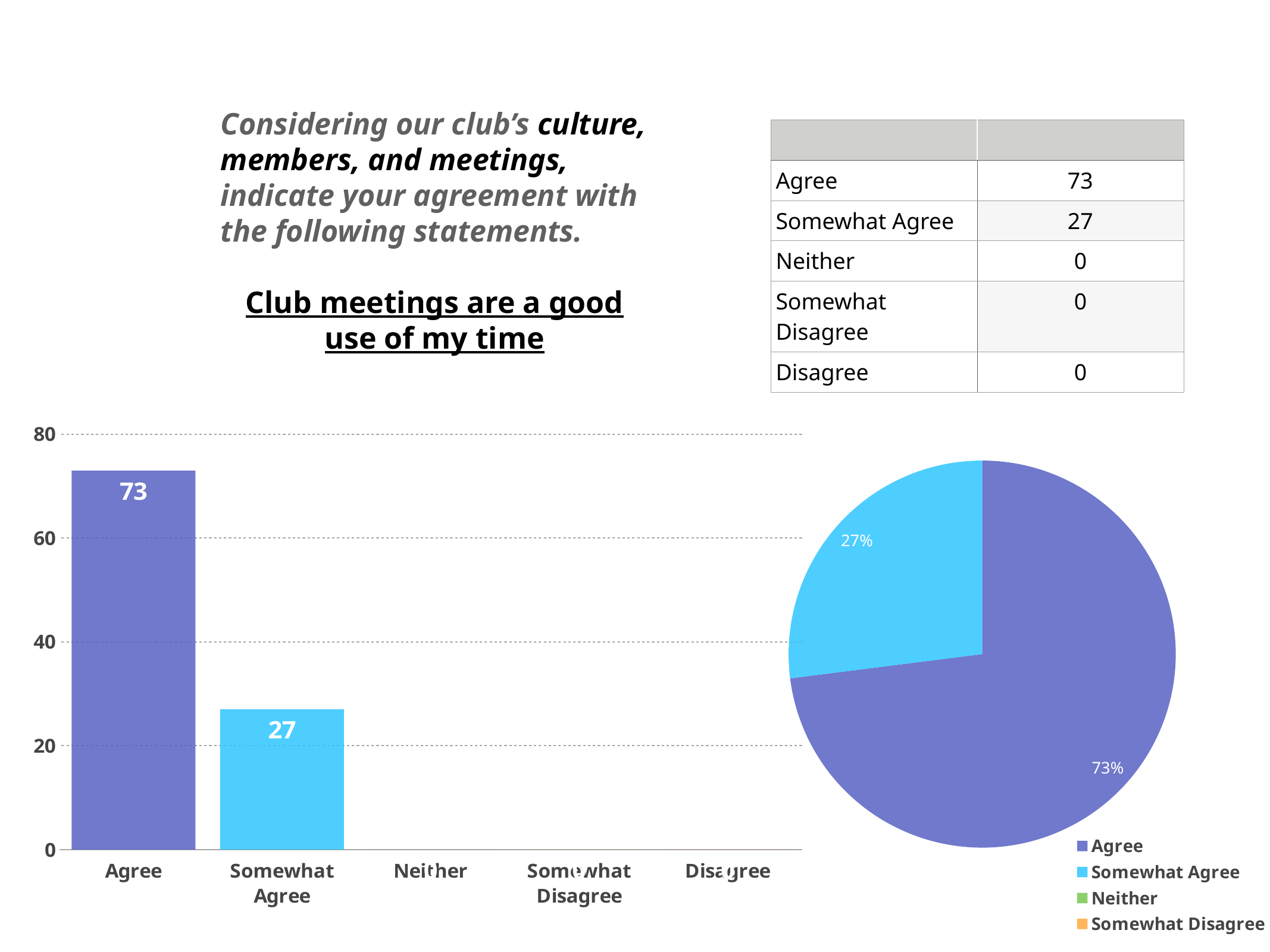
In the bar chart on the left, is the value for Agree greater or less than 60? greater In the bar chart on the left, what is the difference between the values for Agree and Somewhat Agree? 46 In the pie chart on the right, what share does the Agree slice have? 73% In the pie chart on the right, what share does the Somewhat Agree slice have? 27% In the bar chart on the left, which category has the highest value? Agree In the bar chart on the left, which is larger, the value for Agree or the value for Somewhat Agree? Agree How many entries does the legend of the pie chart on the right list? 4 In the bar chart on the left, what is the value for Agree? 73 In the bar chart on the left, how many categories are shown on the x axis? 5 What kind of chart is on the left of the slide? bar chart In the bar chart on the left, what is the value for Somewhat Agree? 27 What kind of chart is on the right of the slide? pie chart